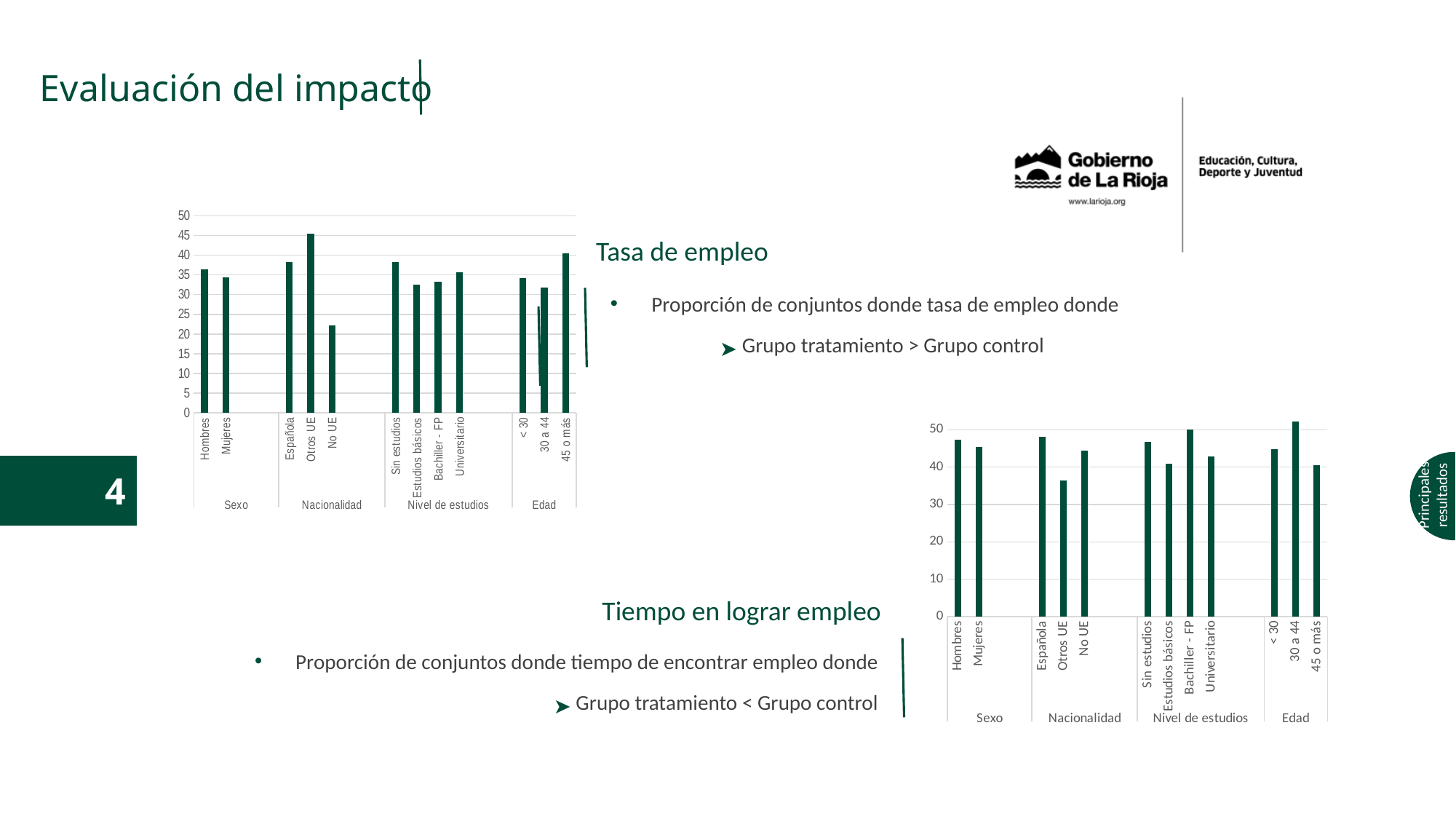
In the left chart (Tasa de empleo), is the value for Otros UE greater or less than 40? greater In the left chart (Tasa de empleo), is the value for No UE greater or less than 25? less In the right chart (Tiempo en lograr empleo), is the value for 30 a 44 greater or less than 50? greater In the right chart (Tiempo en lograr empleo), which category has the lowest bar? Otros UE In the left chart (Tasa de empleo), which is larger, the value for Hombres or the value for No UE? Hombres In the left chart (Tasa de empleo), which category has the highest bar? Otros UE How many categories are plotted in the left chart (Tasa de empleo)? 12 In the right chart (Tiempo en lograr empleo), which is larger, the value for Bachiller - FP or the value for Estudios básicos? Bachiller - FP In the right chart (Tiempo en lograr empleo), which category has the highest bar? 30 a 44 In the left chart (Tasa de empleo), which category has the lowest bar? No UE What kind of chart is the left chart (Tasa de empleo)? bar chart